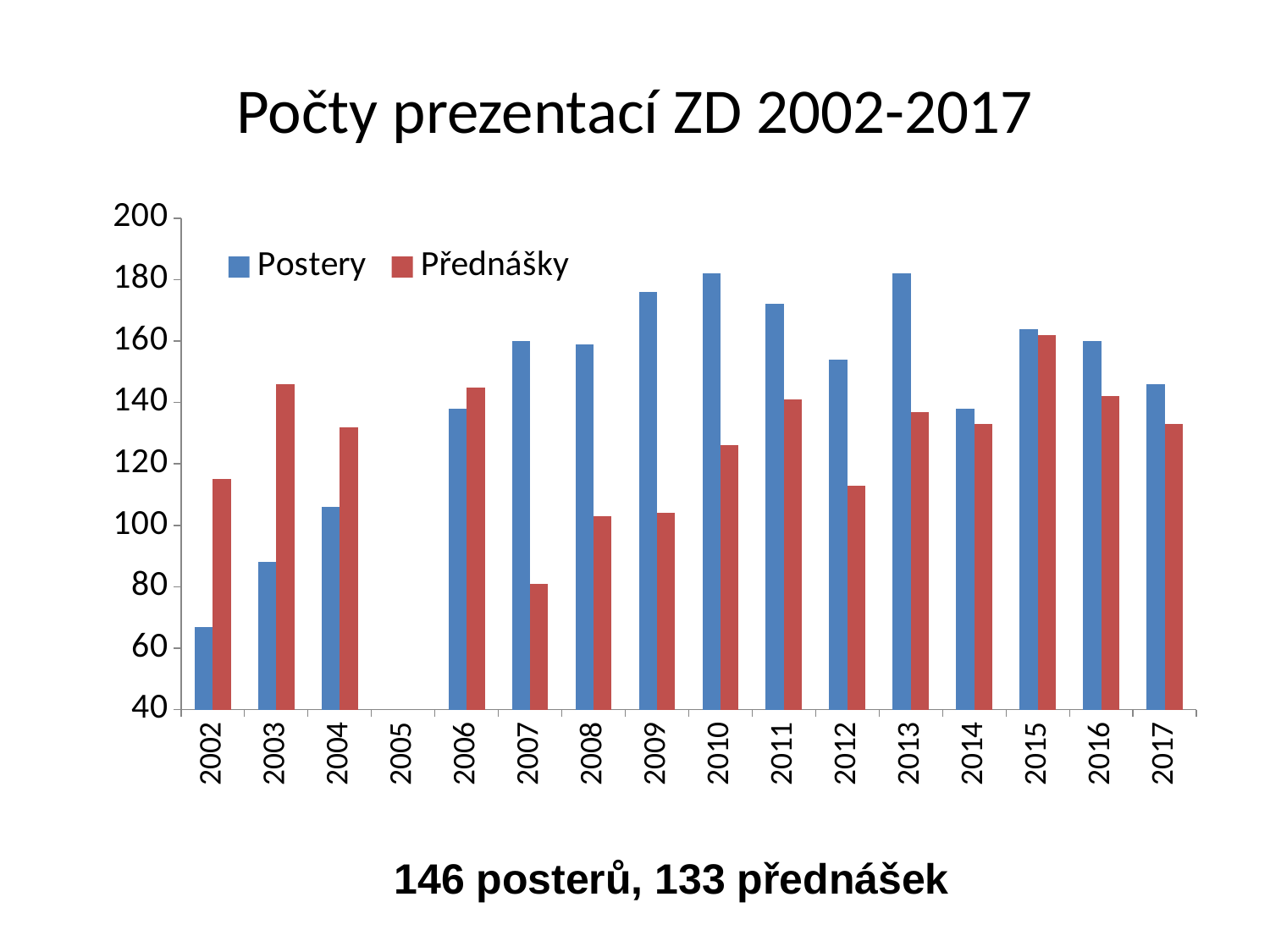
In 2002, which is larger, Postery or Přednášky? Přednášky According to the text below the chart, how many lectures (přednášek) were there in 2017? 133 According to the text below the chart, how many posters (posterů) were there in 2017? 146 What is the title of the chart? Počty prezentací ZD 2002-2017 How many years are labelled on the x axis? 16 Is the Postery value for 2009 greater or less than 160? greater What kind of chart is shown on the slide? bar chart In which year is the Postery value lowest? 2002 In which year is the Přednášky value highest? 2015 In which year is the Přednášky value lowest? 2007 What are the two series named in the legend? Postery and Přednášky How many series does the legend list? 2